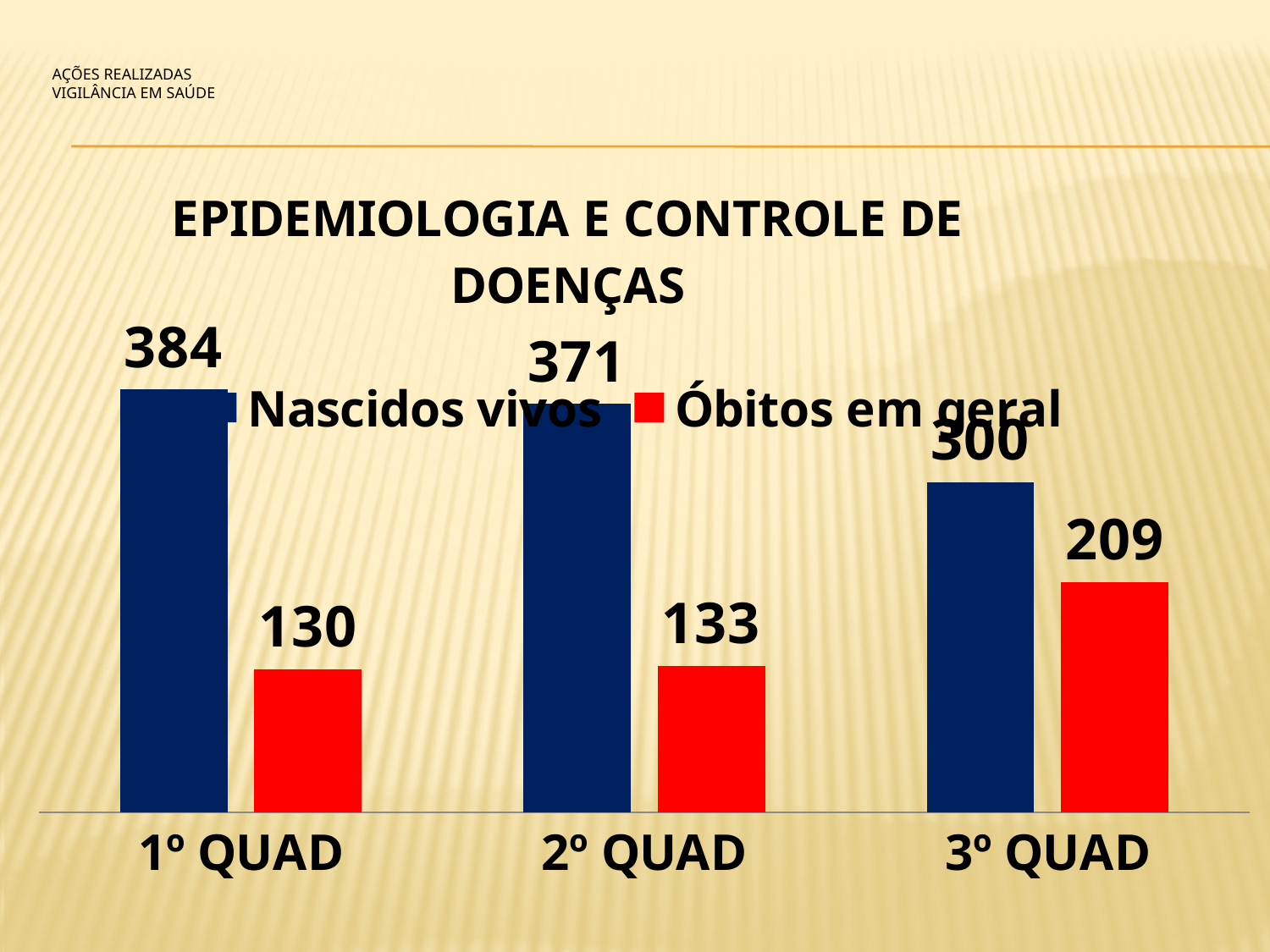
Which is larger: Óbitos em geral in 3º QUAD or Óbitos em geral in 1º QUAD? Óbitos em geral in 3º QUAD How many series does the legend list? 2 What is the difference between Nascidos vivos and Óbitos em geral in 3º QUAD? 91 What kind of chart is shown on the slide? Bar chart What is the difference between Nascidos vivos in 1º QUAD and in 2º QUAD? 13 How many categories are shown on the x axis? 3 What is the value for Nascidos vivos in 1º QUAD? 384 What is the value for Óbitos em geral in 3º QUAD? 209 What is the value for Óbitos em geral in 2º QUAD? 133 Which quadrimester has the lowest value for Óbitos em geral? 1º QUAD Which quadrimester has the highest value for Nascidos vivos? 1º QUAD Do the values for Nascidos vivos rise or fall from 1º QUAD to 3º QUAD? Fall